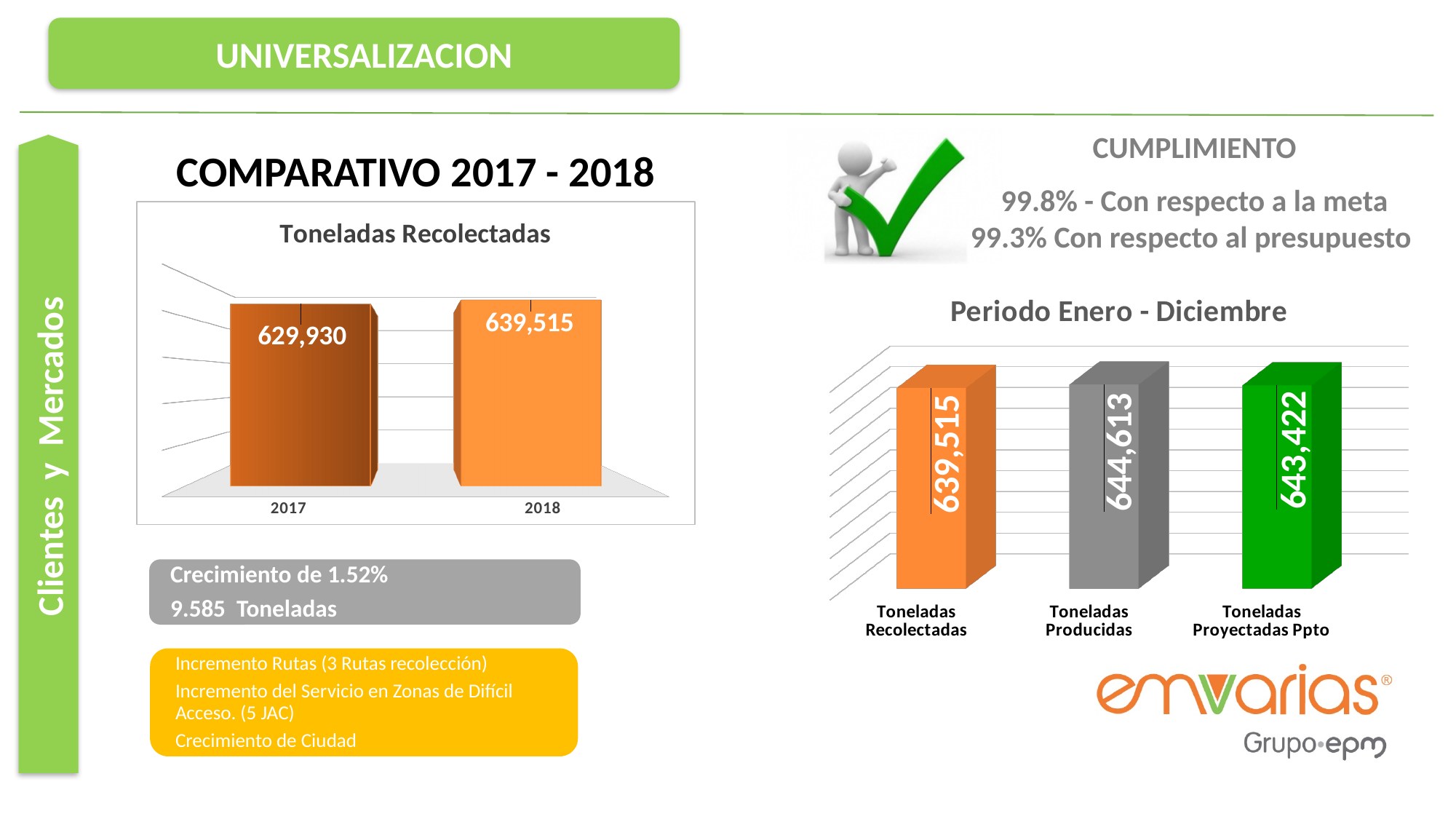
In the 'Toneladas Recolectadas' chart, which year has the higher value, 2017 or 2018? 2018 In the 'Periodo Enero - Diciembre' chart, what is the value for Toneladas Producidas? 644,613 In the 'Toneladas Recolectadas' chart, what is the difference between the 2018 and 2017 values? 9,585 In the 'Toneladas Recolectadas' chart, what is the value for 2017? 629,930 In the 'Toneladas Recolectadas' chart, what is the value for 2018? 639,515 In the 'Periodo Enero - Diciembre' chart, what is the difference between Toneladas Producidas and Toneladas Recolectadas? 5,098 In the 'Toneladas Recolectadas' chart, do the values rise or fall from 2017 to 2018? rise How many categories are shown in the 'Toneladas Recolectadas' chart? 2 What kind of chart is the 'Toneladas Recolectadas' chart? bar chart In the 'Periodo Enero - Diciembre' chart, what is the value for Toneladas Proyectadas Ppto? 643,422 How many bars are shown in the 'Periodo Enero - Diciembre' chart? 3 In the 'Periodo Enero - Diciembre' chart, which category has the highest value? Toneladas Producidas